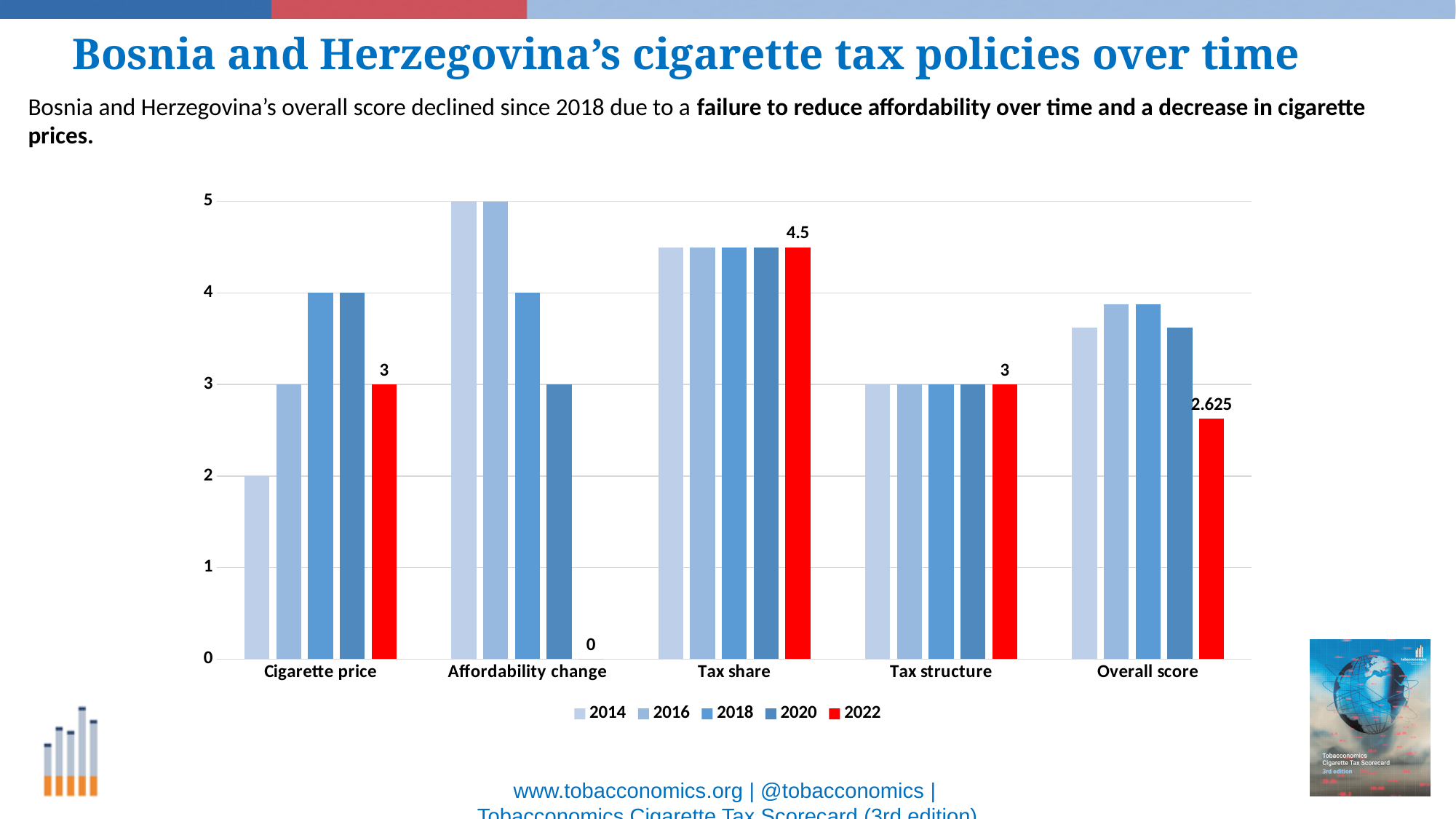
What kind of chart is shown on the slide? Bar chart What is the 2014 value for Cigarette price? 2 Do the Affordability change values rise or fall from 2014 to 2022? fall Which category has the highest 2022 value? Tax share How many categories are shown on the x axis? 5 What is the 2022 value for Affordability change? 0 What is the 2022 value for Tax share? 4.5 What is the difference between the 2022 Tax share value and the 2022 Overall score value? 1.875 What is the 2022 value for Overall score? 2.625 Which category has the lowest 2022 value? Affordability change Is the 2016 value for Overall score greater or less than 3? greater How many series does the legend list? 5